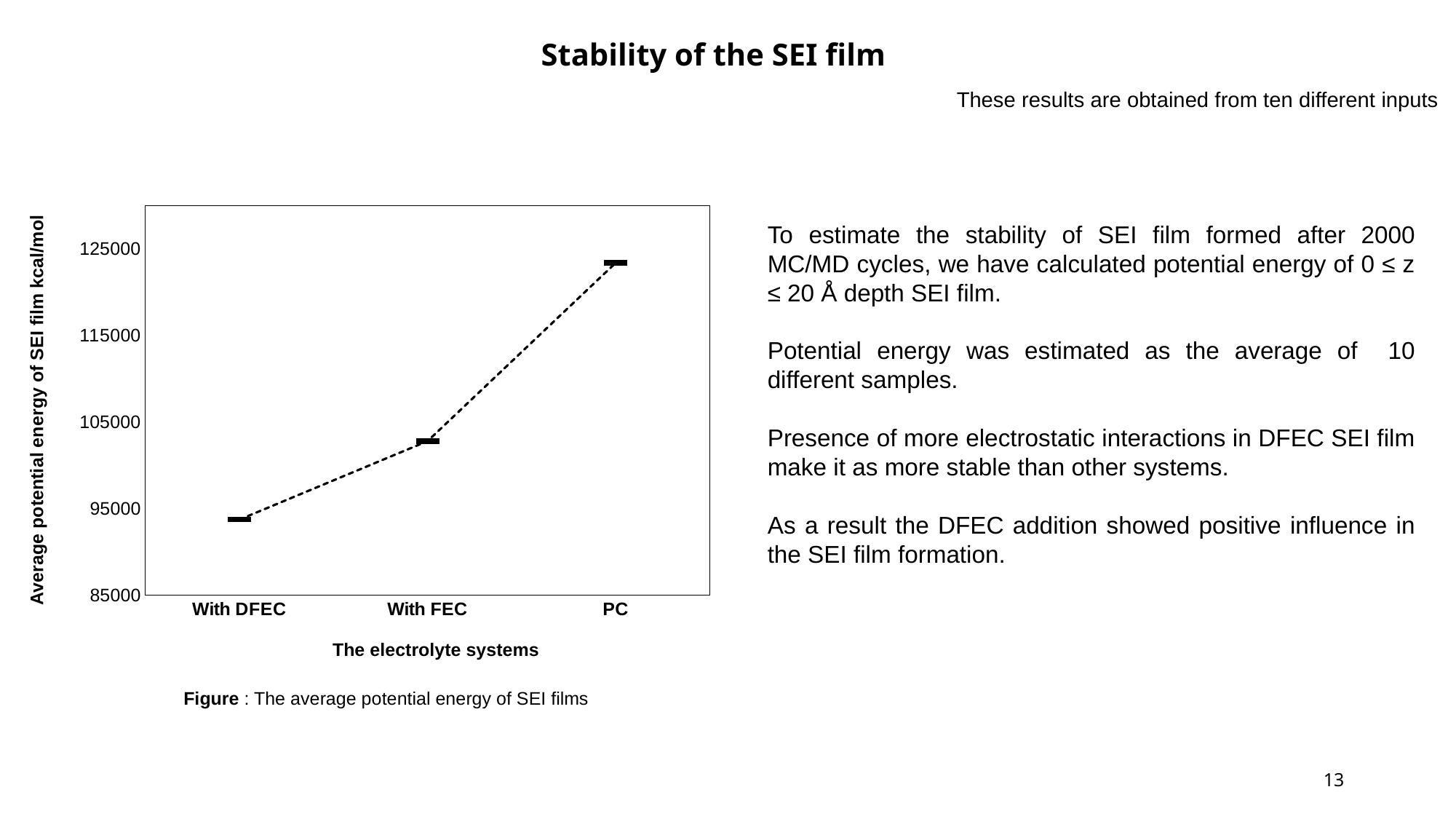
Is the value for With FEC greater or less than 105000? less Which has a larger average potential energy, With FEC or PC? PC Which electrolyte system has the lowest average potential energy of SEI film? With DFEC Is the value for PC greater or less than 115000? greater Which electrolyte system has the highest average potential energy of SEI film? PC How many electrolyte systems are plotted on the x axis? 3 What kind of chart is shown on the slide? line chart Is the value for With DFEC greater or less than 95000? less Do the values rise or fall moving from With DFEC to PC along the x axis? rise What is the title of the x axis of the chart? The electrolyte systems Which has a larger average potential energy, With DFEC or With FEC? With FEC What is the title of the y axis of the chart? Average potential energy of SEI film kcal/mol